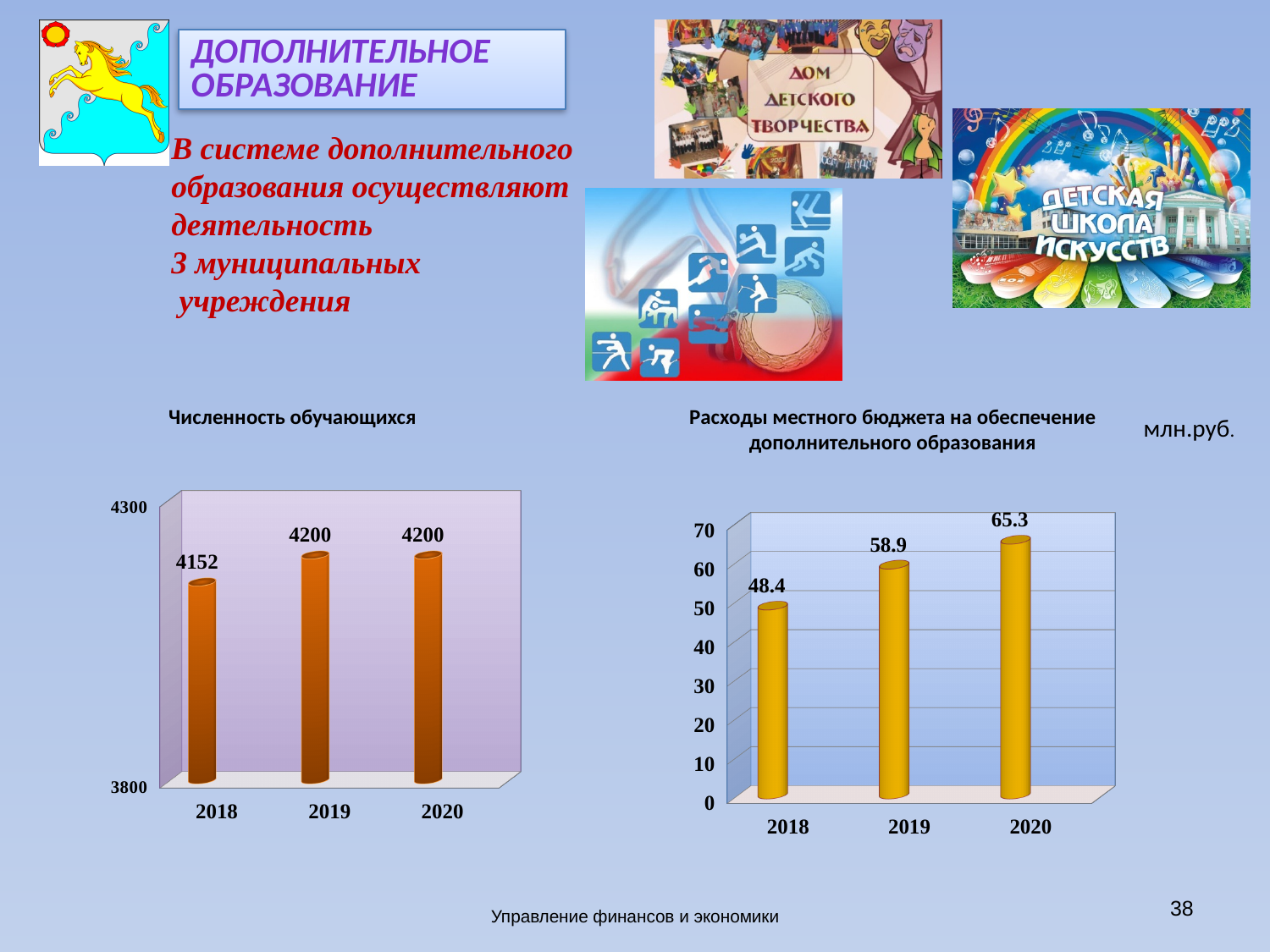
In the 'Расходы местного бюджета на обеспечение дополнительного образования' chart, what is the difference between the 2020 value and the 2018 value? 16.9 In the 'Численность обучающихся' chart, what is the value for 2020? 4200 In the 'Численность обучающихся' chart, what is the value for 2018? 4152 In the 'Расходы местного бюджета на обеспечение дополнительного образования' chart, do the values rise or fall from 2018 to 2020? rise What kind of chart is the 'Расходы местного бюджета на обеспечение дополнительного образования' chart? bar chart In the 'Расходы местного бюджета на обеспечение дополнительного образования' chart, what is the value for 2020? 65.3 In the 'Расходы местного бюджета на обеспечение дополнительного образования' chart, which year has the highest value? 2020 In the 'Расходы местного бюджета на обеспечение дополнительного образования' chart, is the value for 2018 greater or less than 50? less In the 'Численность обучающихся' chart, how many years are shown on the x axis? 3 In the 'Численность обучающихся' chart, which year has the lowest value? 2018 In the 'Численность обучающихся' chart, what is the difference between the 2019 value and the 2018 value? 48 In the 'Расходы местного бюджета на обеспечение дополнительного образования' chart, what is the value for 2019? 58.9